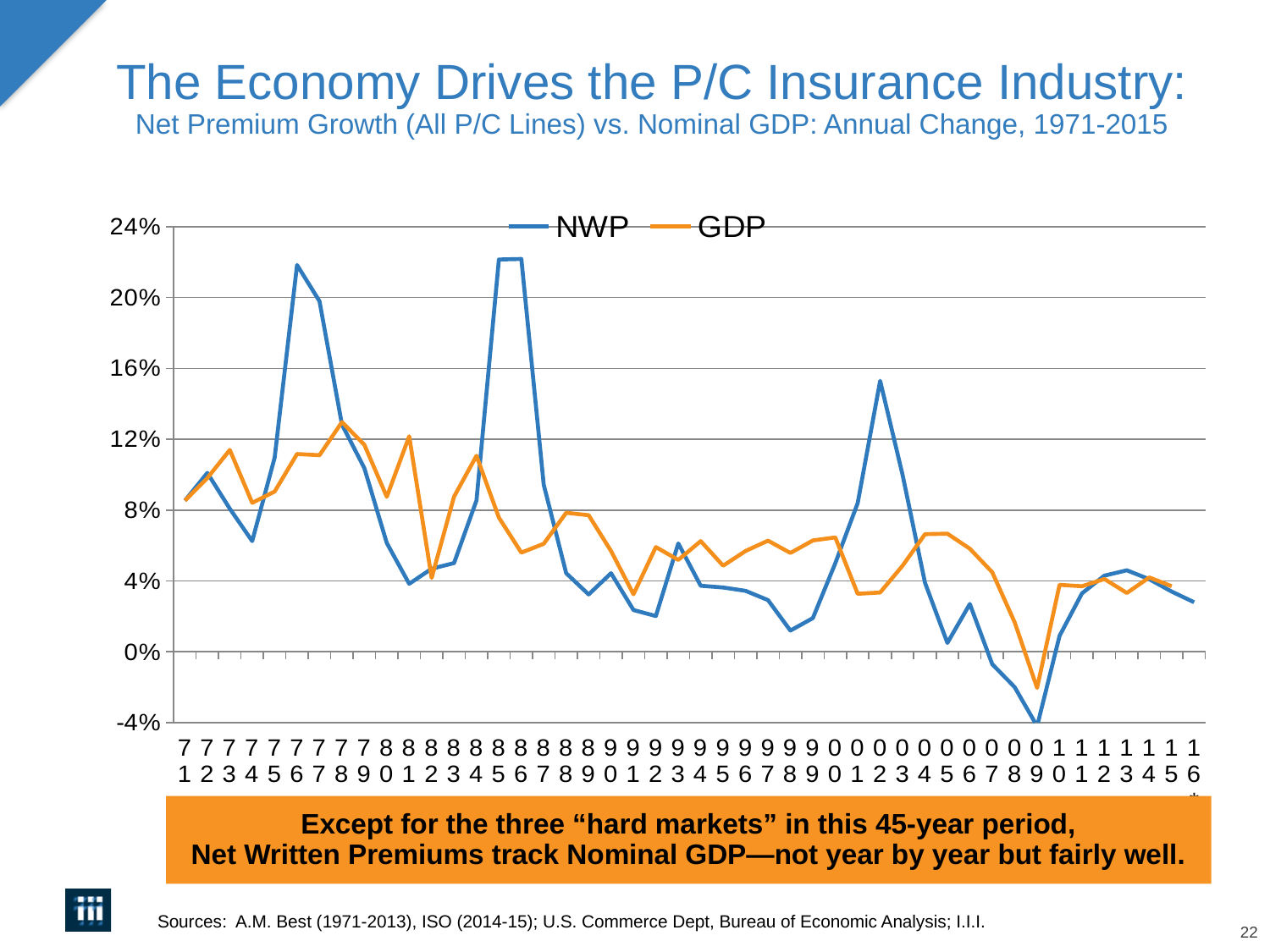
Does the NWP line rise or fall from 2002 to 2009? fall In which year does the NWP line reach its lowest value? 2009 Is the NWP value for 2002 greater or less than 12%? greater How many series does the legend list? 2 Which colour is used for the NWP line? blue Is the NWP value for 2009 greater or less than 0%? less Is the GDP value for 1981 greater or less than 8%? greater In 1981, which series has the higher value, NWP or GDP? GDP In 2002, which series has the higher value, NWP or GDP? NWP What kind of chart is shown on the slide? line chart What are the two series named in the legend? NWP and GDP